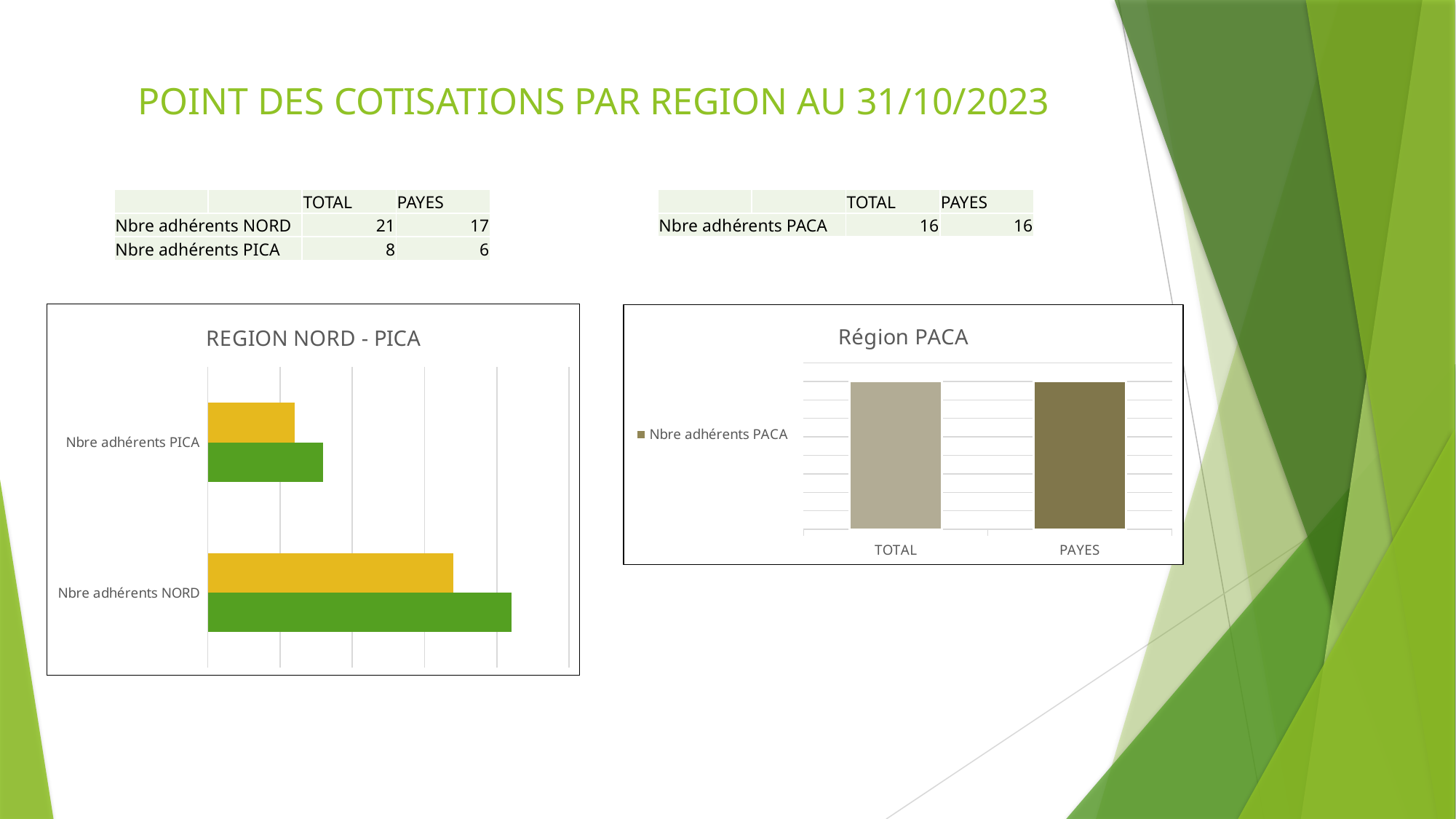
How many categories are shown on the x axis of the "Région PACA" chart? 2 How many series does the legend of the "Région PACA" chart list? 1 What kind of chart is the "Région PACA" chart? bar chart In the "REGION NORD - PICA" chart, which category has the shortest bar? Nbre adhérents PICA According to the table above the "Région PACA" chart, what is the PAYES value for Nbre adhérents PACA? 16 In the "REGION NORD - PICA" chart, is the green bar or the yellow bar longer for Nbre adhérents NORD? green According to the table above the "REGION NORD - PICA" chart, what is the difference between TOTAL and PAYES for Nbre adhérents PICA? 2 What kind of chart is the "REGION NORD - PICA" chart? bar chart According to the table above the "REGION NORD - PICA" chart, what is the TOTAL for Nbre adhérents NORD? 21 In the "REGION NORD - PICA" chart, which category has the longest bar? Nbre adhérents NORD How many categories are shown on the y axis of the "REGION NORD - PICA" chart? 2 What is the legend entry of the "Région PACA" chart? Nbre adhérents PACA